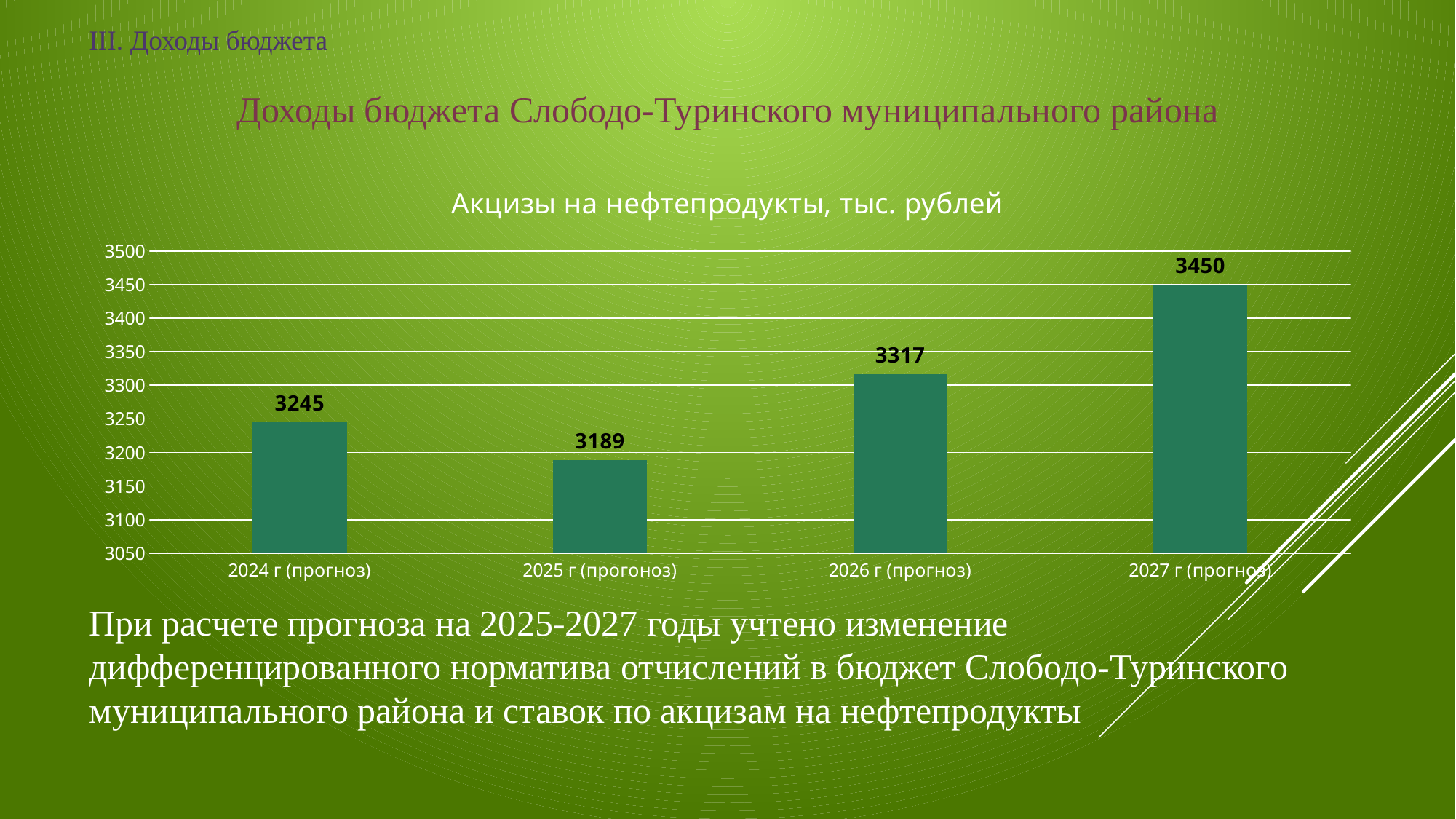
Which is larger, the value for 2024 г (прогноз) or the value for 2025 г (прогоноз)? 2024 г (прогноз) Which year has the lowest value? 2025 г (прогоноз) What is the title of the chart? Акцизы на нефтепродукты, тыс. рублей What kind of chart is shown on the slide? bar chart What is the value for 2025 г (прогоноз)? 3189 What is the difference between the values for 2026 г (прогноз) and 2025 г (прогоноз)? 128 What is the difference between the values for 2027 г (прогноз) and 2024 г (прогноз)? 205 What is the value for 2026 г (прогноз)? 3317 What is the value for 2027 г (прогноз)? 3450 How many categories are shown on the x axis? 4 Which year has the highest value? 2027 г (прогноз) What is the value for 2024 г (прогноз)? 3245